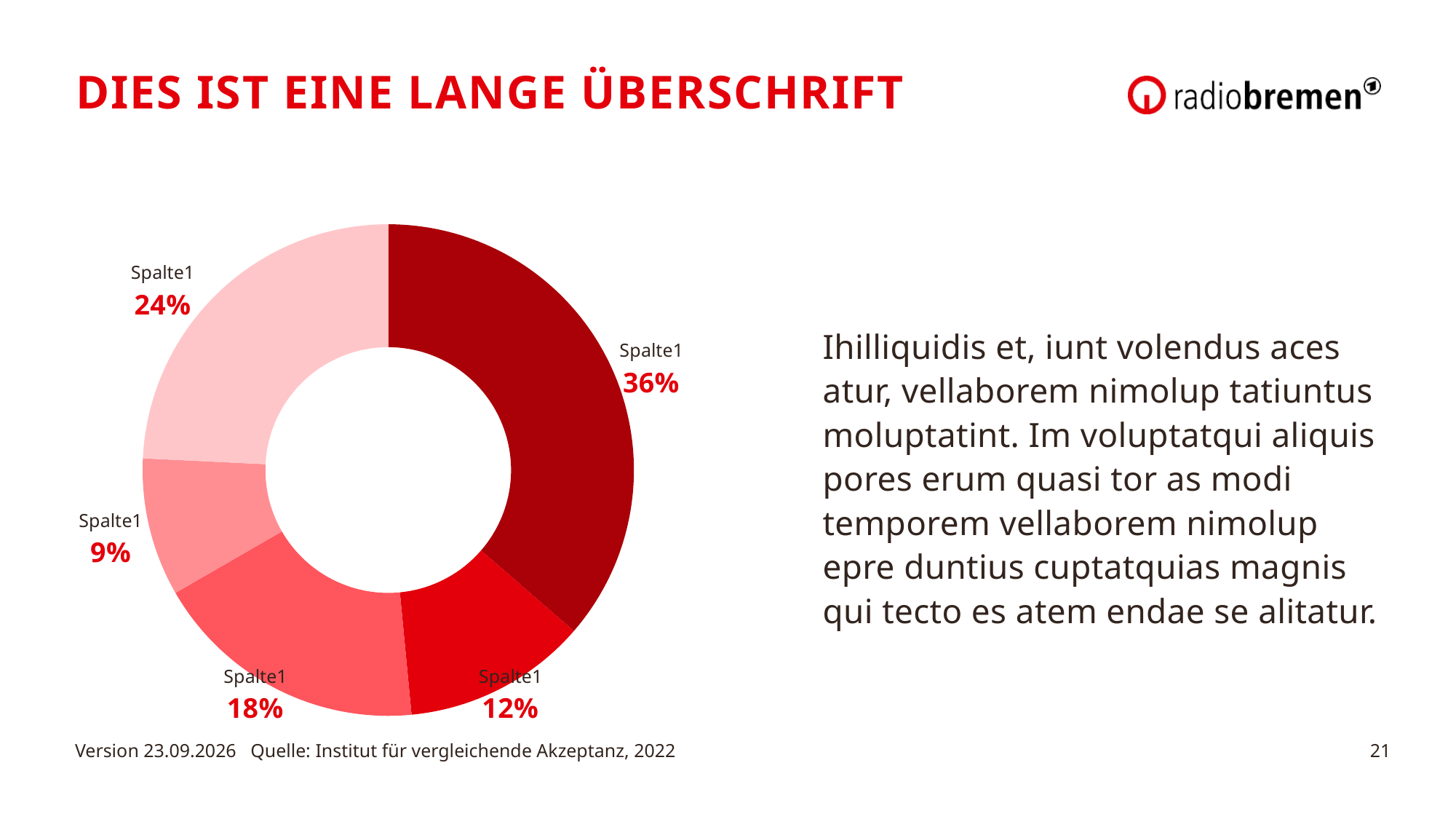
What source is cited for the chart at the bottom of the slide? Institut für vergleichende Akzeptanz, 2022 What percentage is labelled on the darkest red slice on the right side of the doughnut? 36% What percentage is labelled on the bright red slice at the bottom right of the doughnut? 12% What is the difference in percentage points between the 36% slice and the 12% slice? 24 percentage points How many slices does the doughnut chart have? 5 What category label is shown next to every slice of the doughnut chart? Spalte1 What is the largest percentage shown on the doughnut chart? 36% What kind of chart is shown on the slide? doughnut (pie) chart What is the smallest percentage shown on the doughnut chart? 9% Which is larger: the slice labelled 18% at the bottom left or the slice labelled 24% at the top left? the 24% slice What percentage is labelled on the lightest pink slice at the top left of the doughnut? 24% What is the difference in percentage points between the 24% slice and the 9% slice? 15 percentage points